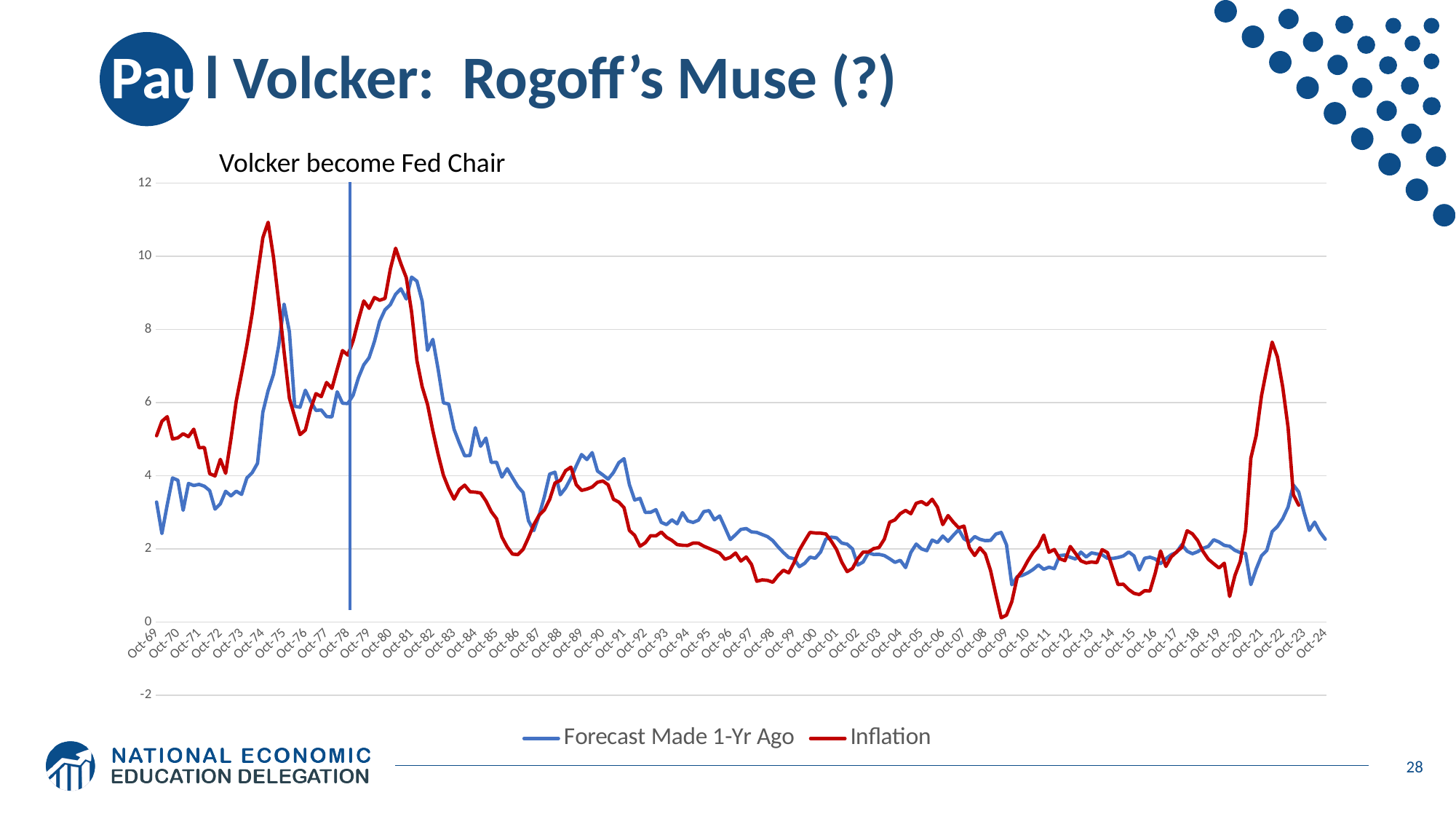
How many series does the chart legend list? 2 Around Oct-09, which series has the larger value, Forecast Made 1-Yr Ago or Inflation? Forecast Made 1-Yr Ago Which series reaches the highest value anywhere on the chart? Inflation Which series is drawn in red? Inflation Is the value of Inflation around Oct-09 greater or less than 2? less Is the peak value of Forecast Made 1-Yr Ago around Oct-81 greater or less than 8? greater Does Inflation rise or fall between Oct-81 and Oct-86? fall Is the peak value of Inflation around Oct-22 greater or less than 6? greater Around Oct-74, which series has the larger value, Forecast Made 1-Yr Ago or Inflation? Inflation What event does the vertical line annotation on the chart mark? Volcker become Fed Chair What kind of chart is shown on the slide? line chart